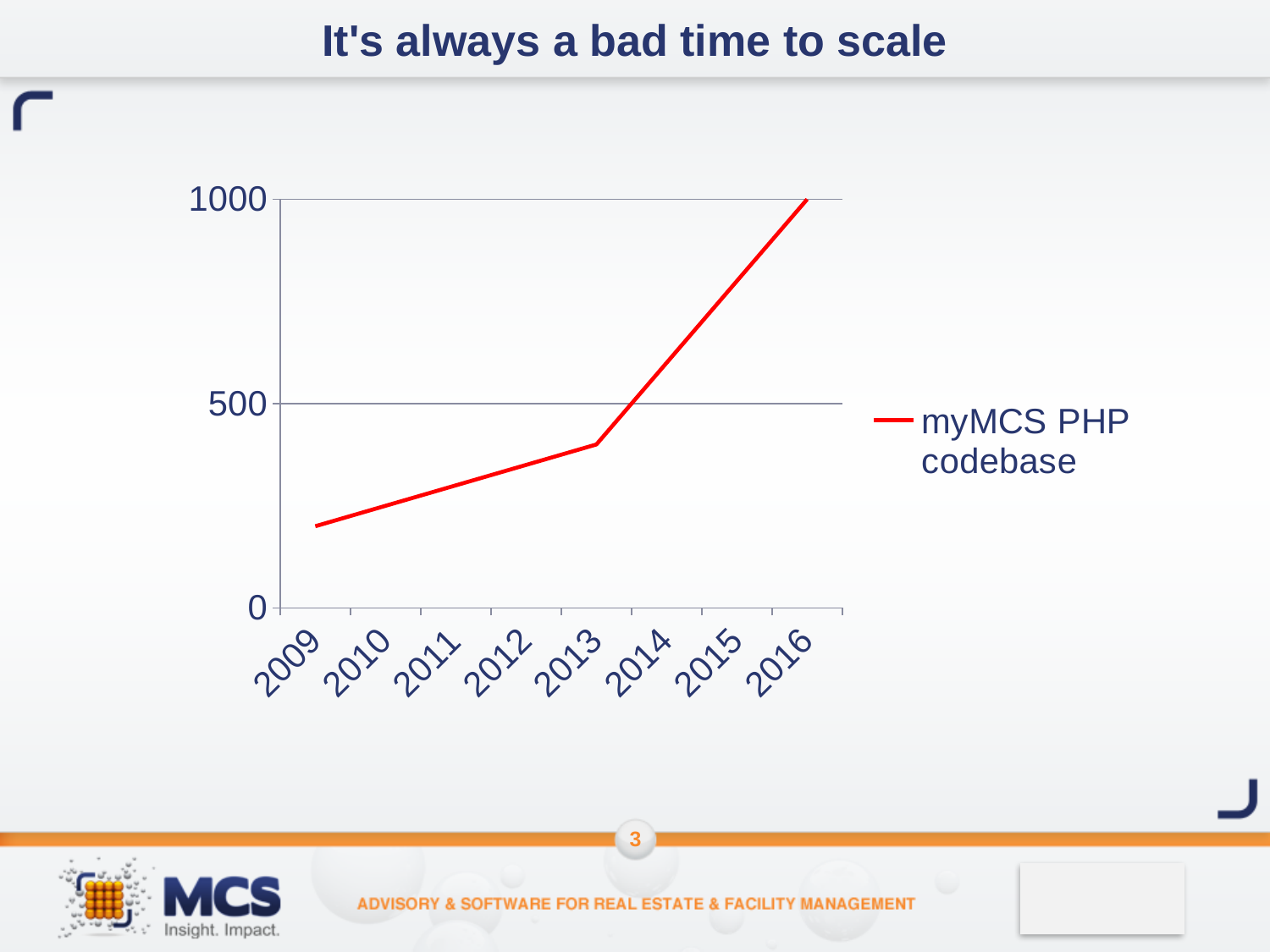
Does the myMCS PHP codebase line rise or fall from 2009 to 2016? rise What is the title of the slide containing the chart? It's always a bad time to scale How many years are shown on the x axis? 8 Is the value for 2009 greater or less than 500? less Is the value for 2013 greater or less than 500? less How many series does the legend list? 1 In which year is the myMCS PHP codebase value lowest? 2009 Which year has the larger value, 2011 or 2015? 2015 Is the value for 2015 greater or less than 500? greater What is the name of the series shown in the legend? myMCS PHP codebase What kind of chart is shown on the slide? line chart In which year is the myMCS PHP codebase value highest? 2016